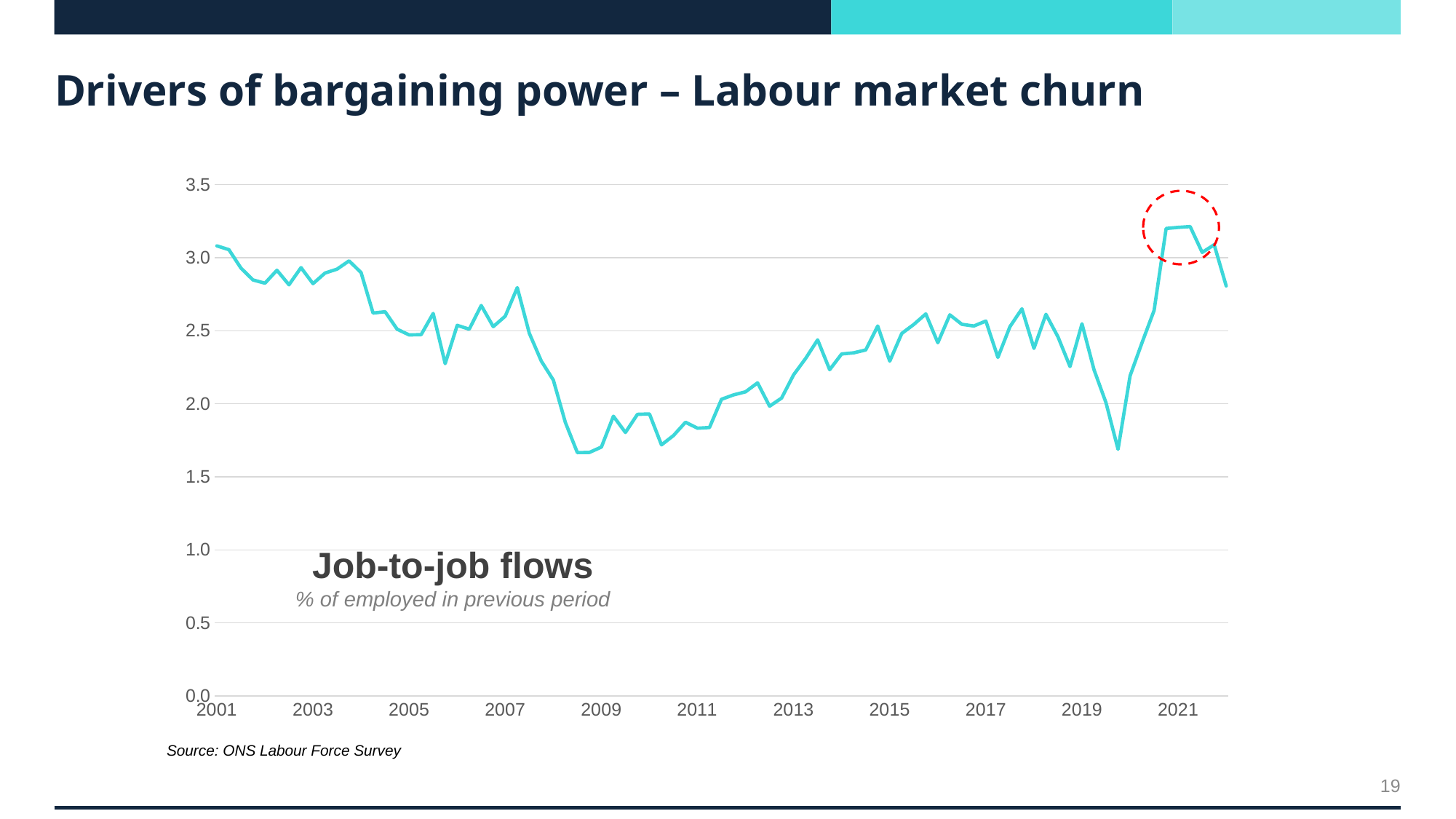
Is the value of job-to-job flows in 2013 greater or less than 1.5? greater Do job-to-job flows rise or fall between 2009 and 2013? rise What is the title of the chart? Job-to-job flows Is the value of job-to-job flows in 2009 greater or less than 2.0? less What unit does the chart subtitle say the values are measured in? % of employed in previous period What kind of chart is shown on the slide? Line chart Is the value of job-to-job flows in 2015 greater or less than 2.0? greater Do job-to-job flows rise or fall between 2007 and 2009? fall Is the value of job-to-job flows in 2009 larger or smaller than the value in 2021? smaller